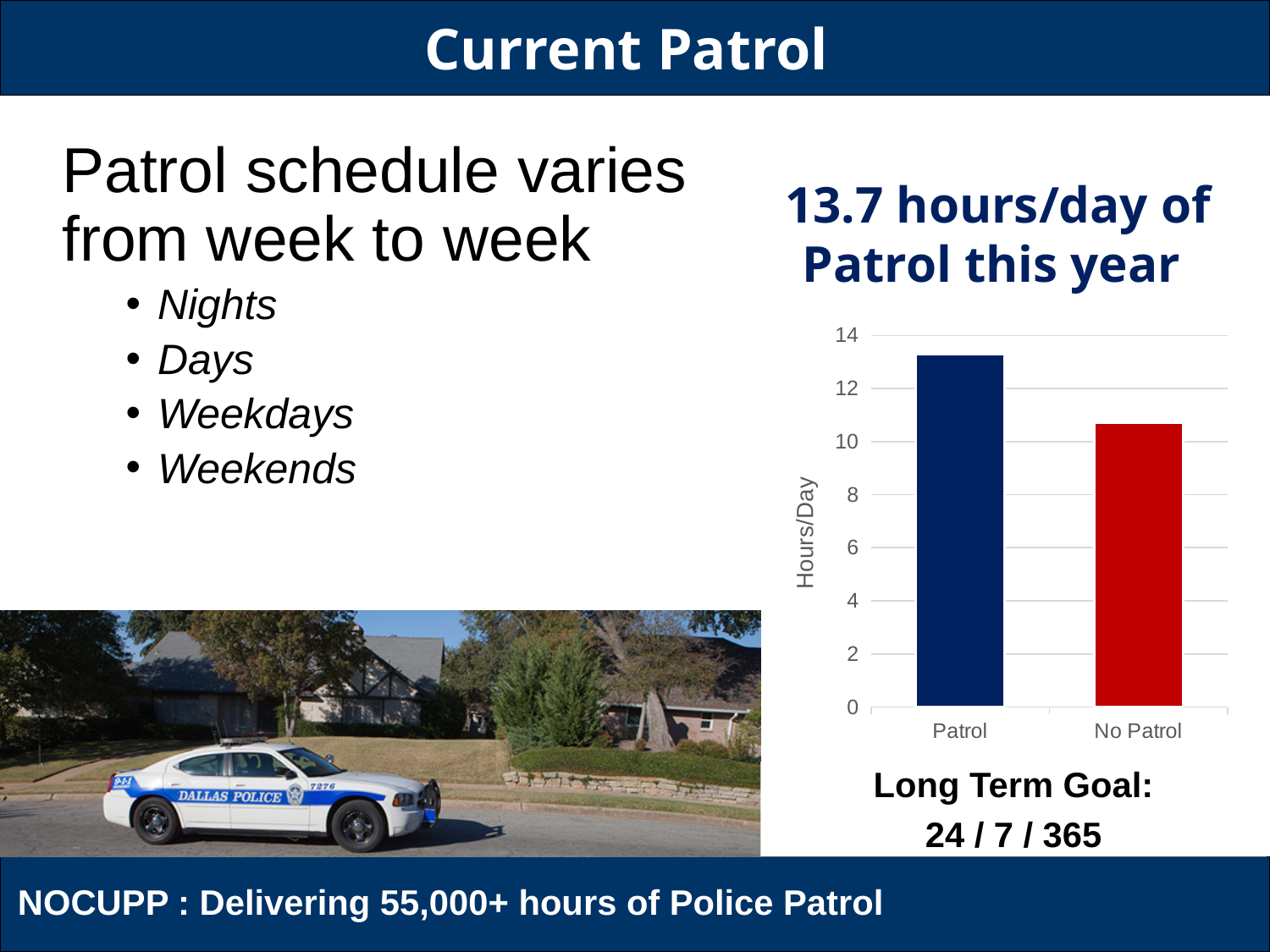
What colour is the bar for No Patrol? red What is the label of the vertical axis of the chart? Hours/Day What kind of chart is shown on the slide? bar chart Is the value for Patrol greater or less than 12? greater Is the value for No Patrol greater or less than 12? less How many categories are shown on the x axis of the chart? 2 Which category has the highest value in the chart? Patrol Is the value for Patrol greater or less than 14? less Which category has the lowest value in the chart? No Patrol Which is larger, the value for Patrol or the value for No Patrol? Patrol